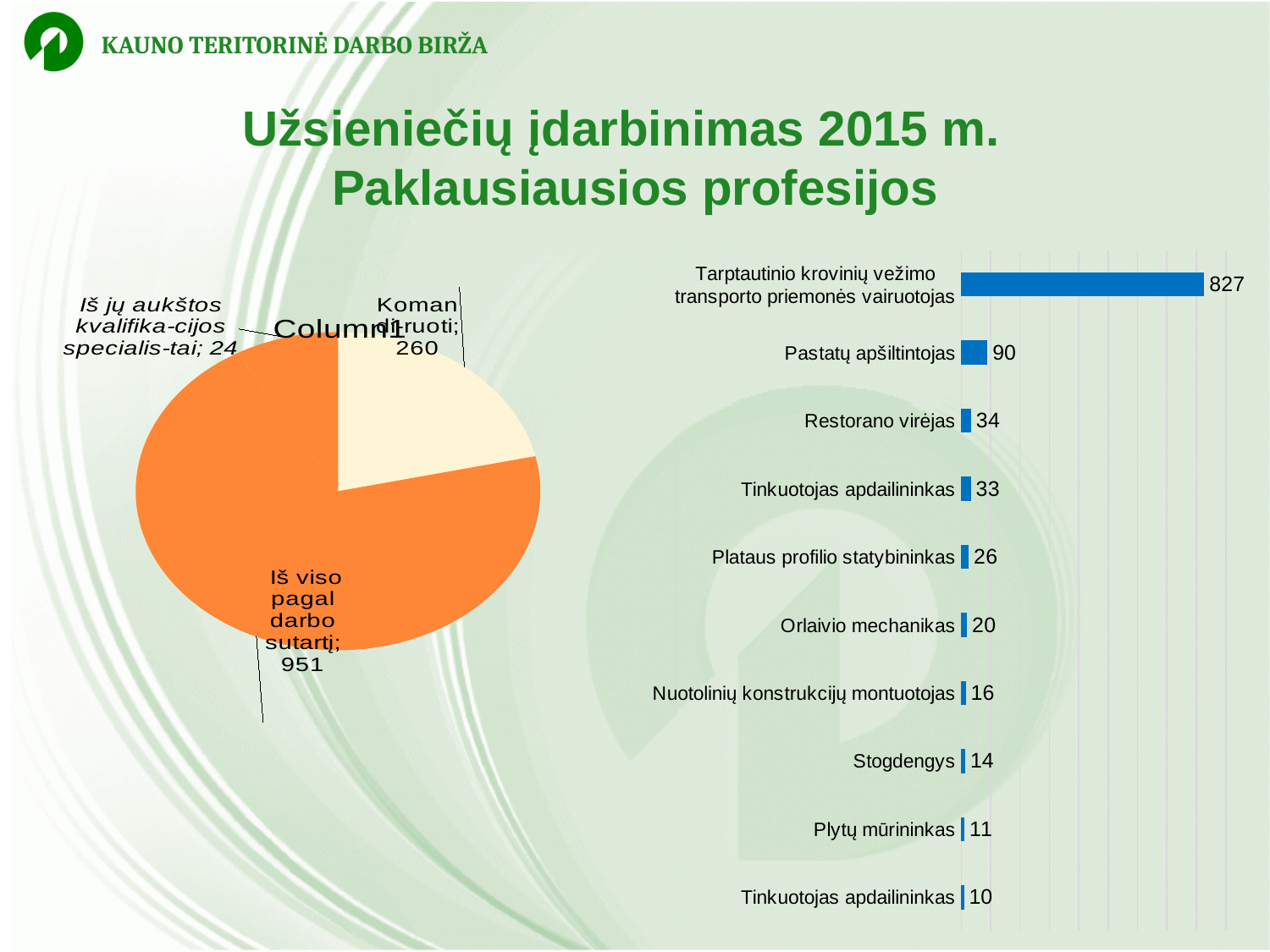
In the bar chart on the right, what is the value for Orlaivio mechanikas? 20 What type of chart is shown on the right side of the slide? Bar chart In the bar chart on the right, which category has the highest value? Tarptautinio krovinių vežimo transporto priemonės vairuotojas What type of chart is shown on the left side of the slide? Pie chart How many bars are shown in the bar chart on the right? 10 In the pie chart on the left, what is the value for Iš viso pagal darbo sutartį? 951 In the pie chart on the left, what is the value for Komandiruoti? 260 In the bar chart on the right, which is larger: the value for Plataus profilio statybininkas or the value for Plytų mūrininkas? Plataus profilio statybininkas In the bar chart on the right, what is the value for Tarptautinio krovinių vežimo transporto priemonės vairuotojas? 827 In the bar chart on the right, what is the difference between the values for Pastatų apšiltintojas and Restorano virėjas? 56 In the bar chart on the right, what is the value for Stogdengys? 14 In the bar chart on the right, what is the value for Pastatų apšiltintojas? 90